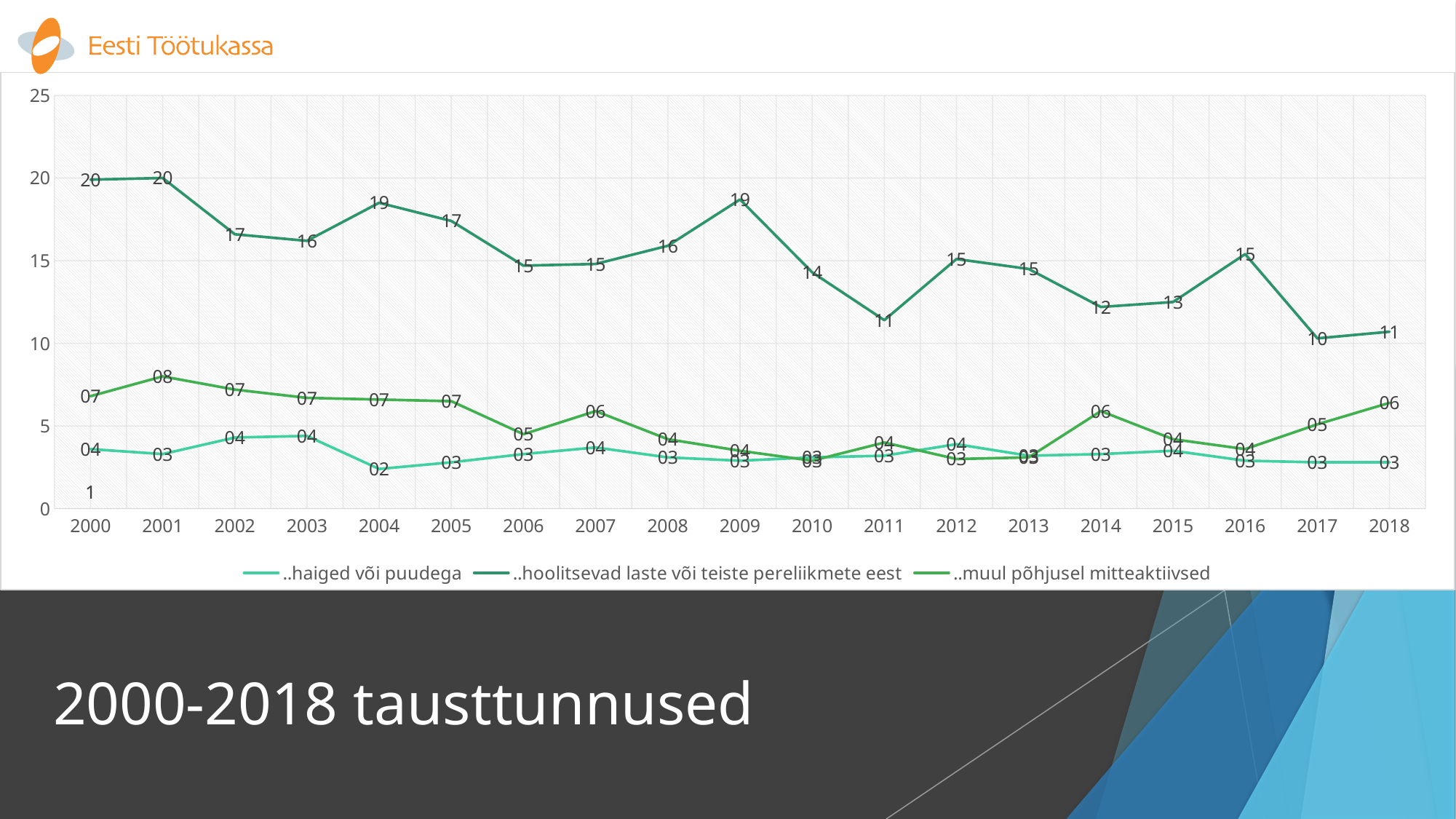
What is the value for "..hoolitsevad laste või teiste pereliikmete eest" in 2009? 19 Which series has the higher value in 2014: "..muul põhjusel mitteaktiivsed" or "..haiged või puudega"? ..muul põhjusel mitteaktiivsed What kind of chart is shown on the slide? line chart What is the value for "..muul põhjusel mitteaktiivsed" in 2001? 08 What is the difference between the 2000 and 2018 values for "..hoolitsevad laste või teiste pereliikmete eest"? 9 How many years are plotted along the x axis? 19 How many series does the legend list? 3 Overall, does the line for "..hoolitsevad laste või teiste pereliikmete eest" rise or fall from 2000 to 2018? fall Which series is drawn with the darkest green line? ..hoolitsevad laste või teiste pereliikmete eest In which year is the value for "..hoolitsevad laste või teiste pereliikmete eest" lowest? 2017 What is the value for "..haiged või puudega" in 2004? 02 What is the value for "..hoolitsevad laste või teiste pereliikmete eest" in 2018? 11